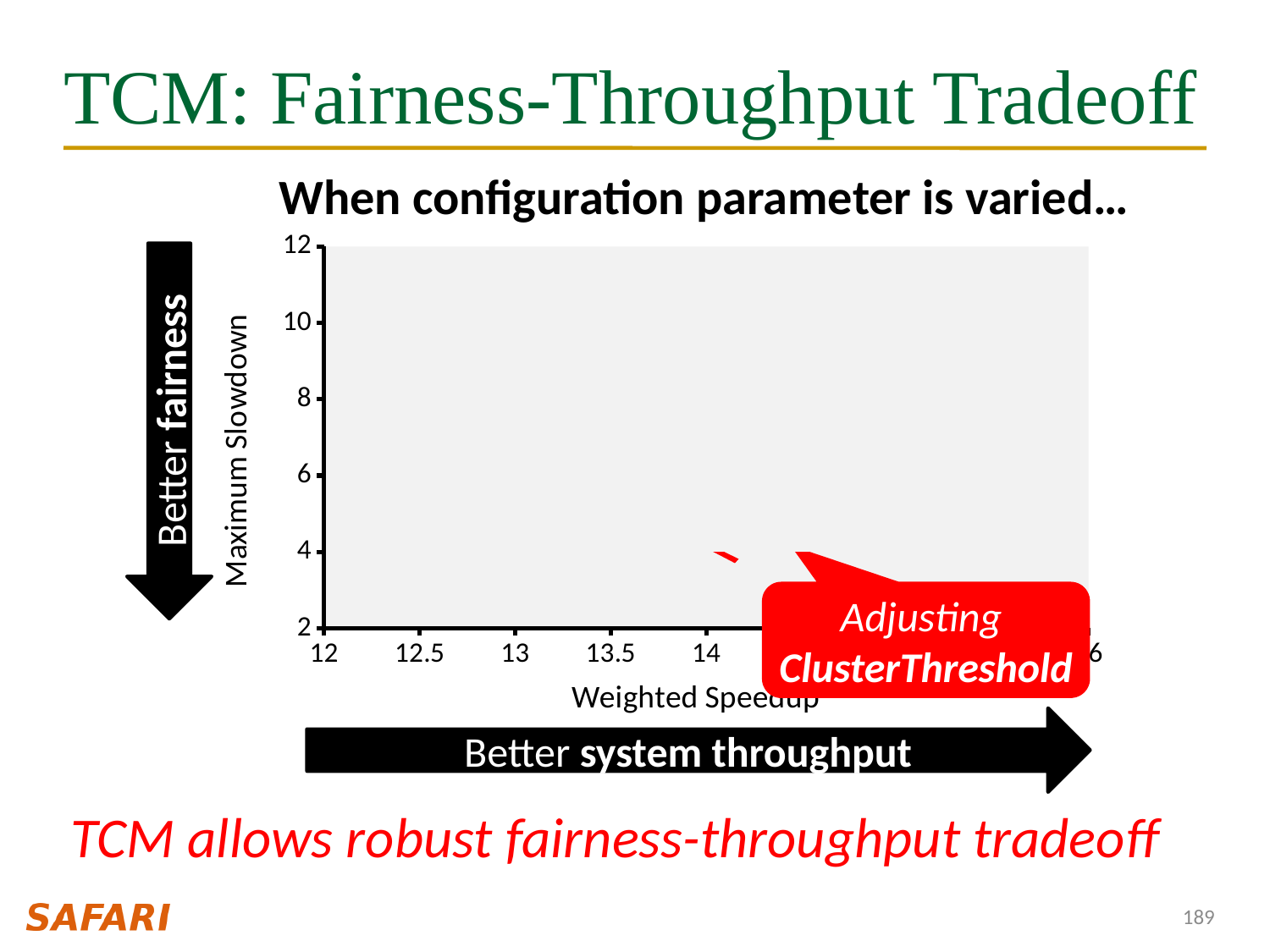
What is the lowest value shown on the y axis of the chart? 2 What is the highest value shown on the y axis of the chart? 12 Is the Maximum Slowdown of the visible red data point greater or less than 6? less What is the label of the y axis of the chart? Maximum Slowdown Is the Weighted Speedup of the visible red data point greater or less than 13? greater